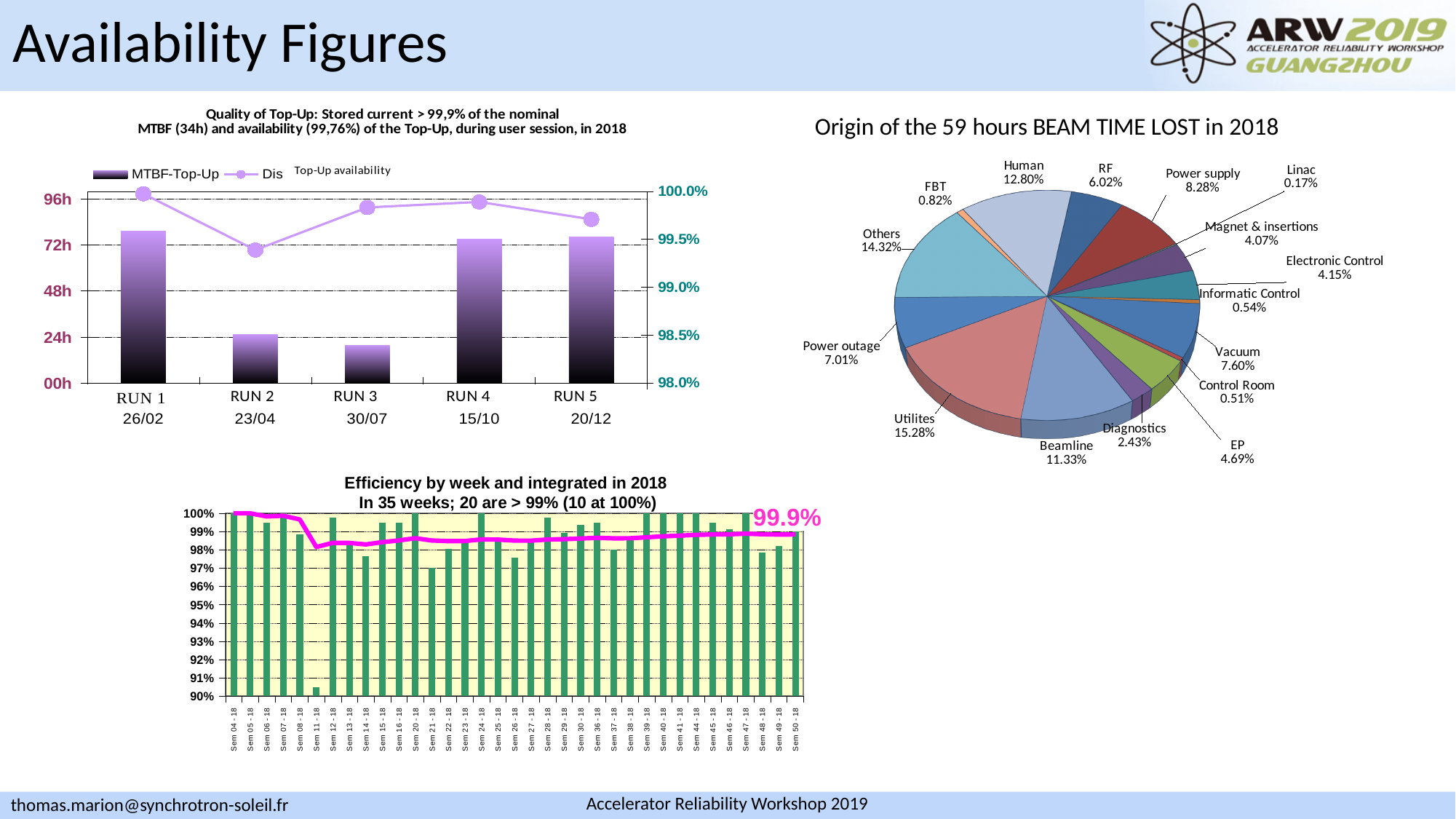
In the top-left chart 'Quality of Top-Up', which RUN has the lowest MTBF-Top-Up bar? RUN 3 How many slices does the pie chart 'Origin of the 59 hours BEAM TIME LOST in 2018' have? 16 In the pie chart 'Origin of the 59 hours BEAM TIME LOST in 2018', which category has the smallest share? Linac How many series does the legend of the top-left chart 'Quality of Top-Up' list? 2 In the bottom chart 'Efficiency by week and integrated in 2018', which week has the lowest bar? Sem 11 - 18 In the pie chart 'Origin of the 59 hours BEAM TIME LOST in 2018', which is larger: the share for Beamline or the share for Power supply? Beamline In the pie chart 'Origin of the 59 hours BEAM TIME LOST in 2018', which category has the largest share? Utilites In the pie chart 'Origin of the 59 hours BEAM TIME LOST in 2018', what is the difference between the Others share and the Vacuum share? 6.72% In the pie chart 'Origin of the 59 hours BEAM TIME LOST in 2018', what share is attributed to Utilites? 15.28% In the top-left chart 'Quality of Top-Up', is the MTBF-Top-Up value for RUN 1 greater or less than 72h? greater In the pie chart 'Origin of the 59 hours BEAM TIME LOST in 2018', what share is attributed to Human? 12.80%